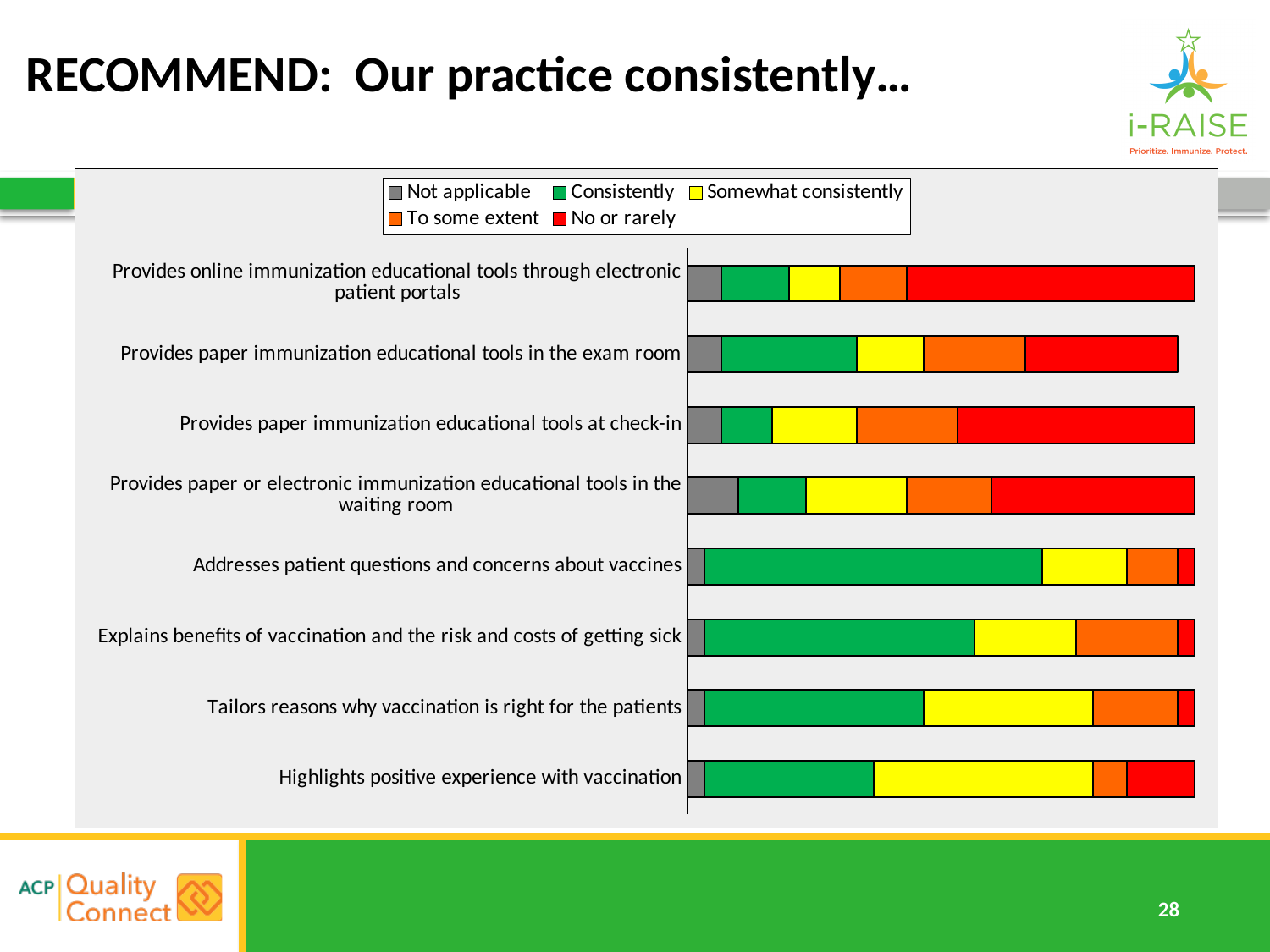
What kind of chart is shown on the slide? Stacked bar chart Which category has the largest 'No or rarely' (red) segment? Provides online immunization educational tools through electronic patient portals Which series in the legend is shown in grey? Not applicable Which category has the smallest 'Consistently' (green) segment? Provides paper immunization educational tools at check-in Which series in the legend is shown in red? No or rarely How many series does the chart's legend list? 5 Is the 'Somewhat consistently' segment larger for 'Highlights positive experience with vaccination' or for 'Provides online immunization educational tools through electronic patient portals'? Highlights positive experience with vaccination Which category has the largest 'Somewhat consistently' (yellow) segment? Highlights positive experience with vaccination Is the 'No or rarely' segment larger for 'Provides paper immunization educational tools at check-in' or for 'Tailors reasons why vaccination is right for the patients'? Provides paper immunization educational tools at check-in Is the 'Consistently' segment larger for 'Addresses patient questions and concerns about vaccines' or for 'Provides paper immunization educational tools at check-in'? Addresses patient questions and concerns about vaccines Which category has the largest 'Consistently' (green) segment? Addresses patient questions and concerns about vaccines How many categories (practice statements) are plotted in the chart? 8